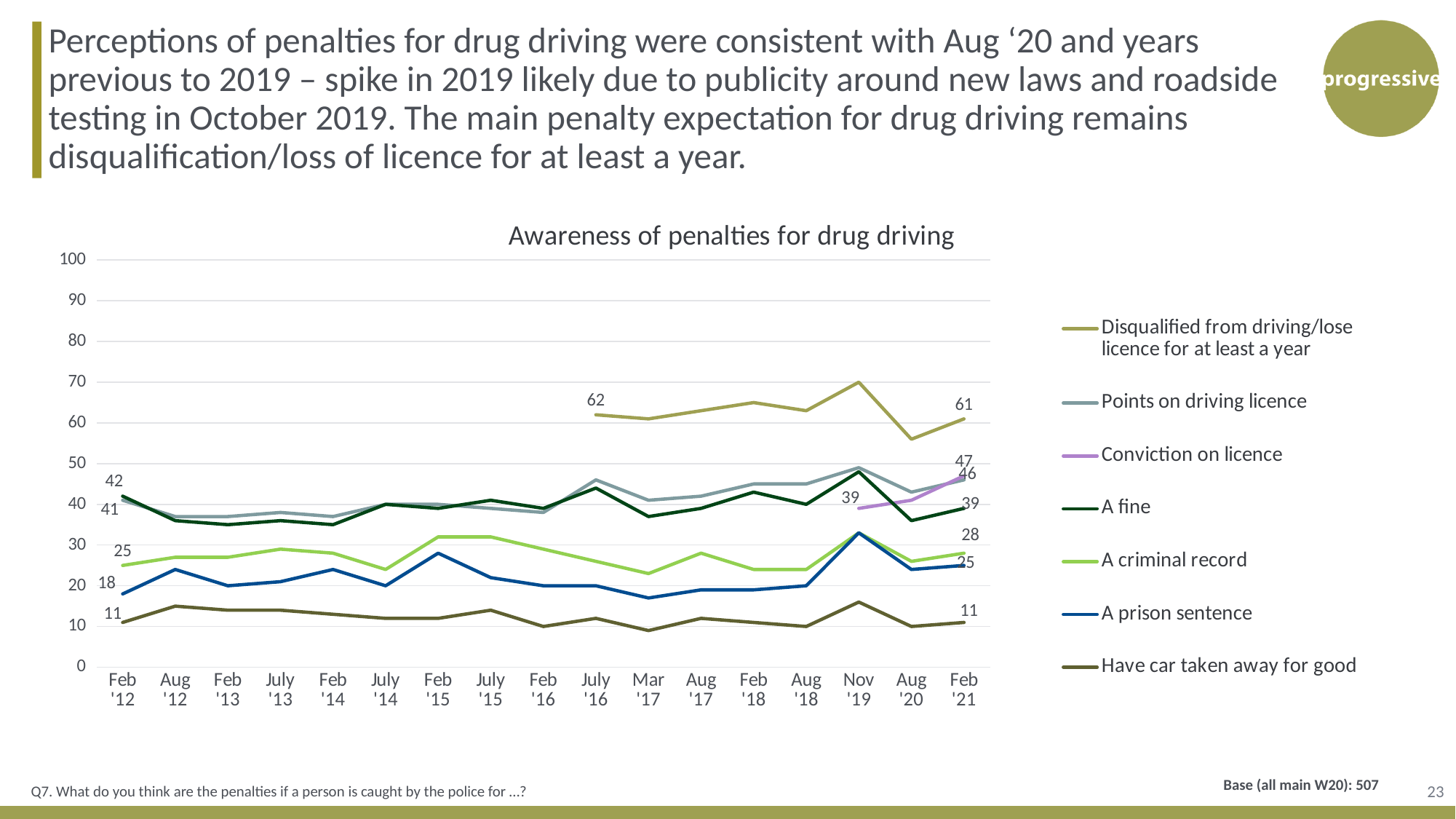
How many time points are shown along the x axis? 17 What is the value for 'Have car taken away for good' at Feb '21? 11 What is the value for 'Disqualified from driving/lose licence for at least a year' at Feb '21? 61 Is the value for 'Disqualified from driving/lose licence for at least a year' at Nov '19 greater or less than 60? greater Which is larger for 'A prison sentence': the value at Feb '12 or at Feb '21? Feb '21 What is the value for 'A criminal record' at Feb '12? 25 By how much did the value for 'A fine' change between Feb '12 and Feb '21? It decreased by 3 (from 42 to 39) How many series does the legend list? 7 Which series has the highest value at Feb '21? Disqualified from driving/lose licence for at least a year What is the value for 'Disqualified from driving/lose licence for at least a year' at July '16? 62 What is the value for 'A fine' at Feb '21? 39 What kind of chart is shown on the slide? Line chart